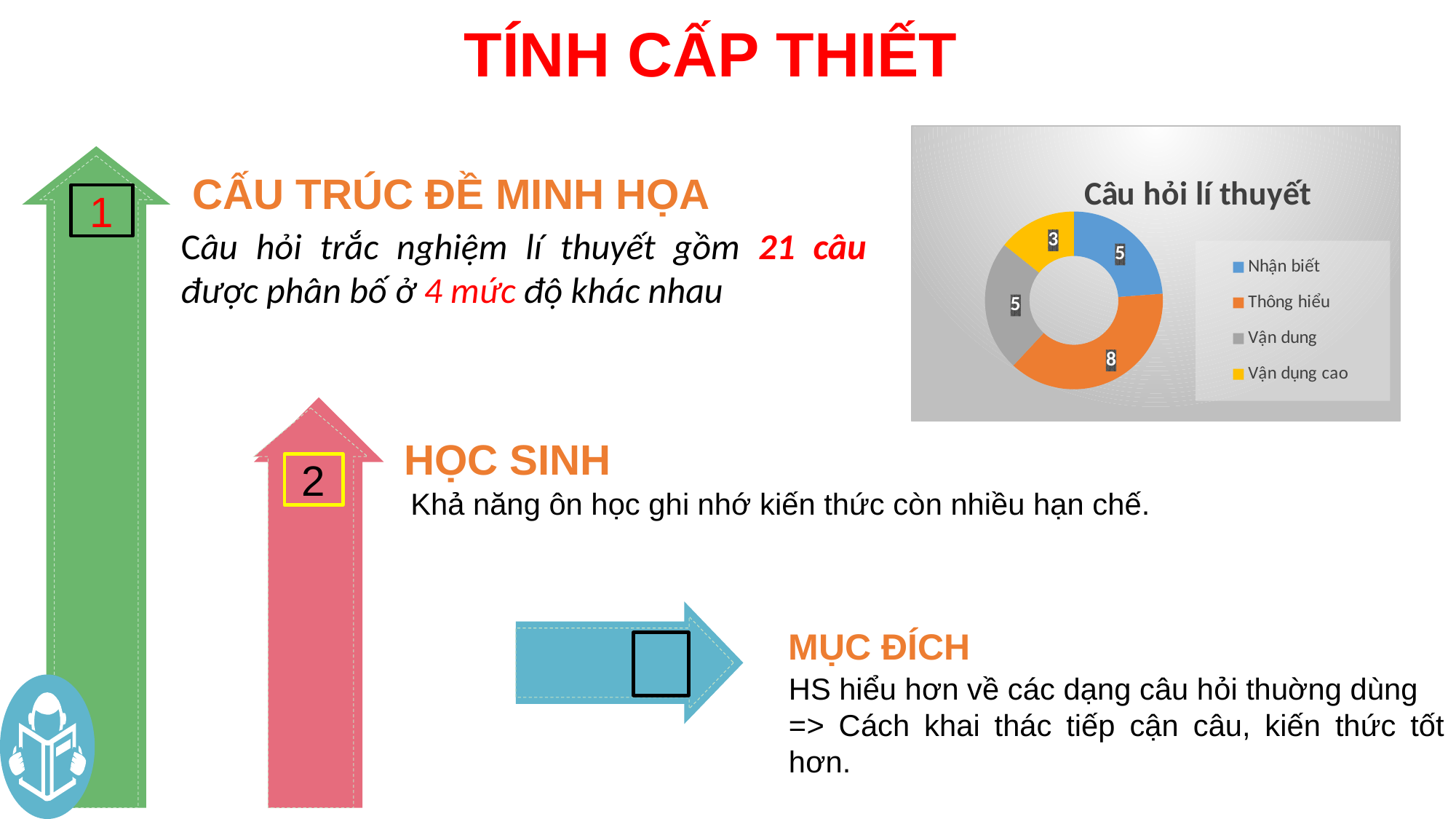
What is the value for Vận dụng cao in the chart? 3 Which is larger, the value for Thông hiểu or the value for Vận dụng? Thông hiểu What is the difference between the values for Thông hiểu and Vận dụng cao? 5 Which category has the highest value in the chart? Thông hiểu Which colour represents Vận dụng cao in the chart legend? Yellow What is the total of all values shown in the chart? 21 What is the value for Thông hiểu in the chart? 8 How many categories does the chart show? 4 What is the title of the chart on the slide? Câu hỏi lí thuyết Which category has the lowest value in the chart? Vận dụng cao What is the value for Nhận biết in the chart? 5 What type of chart is shown on the slide? Doughnut chart